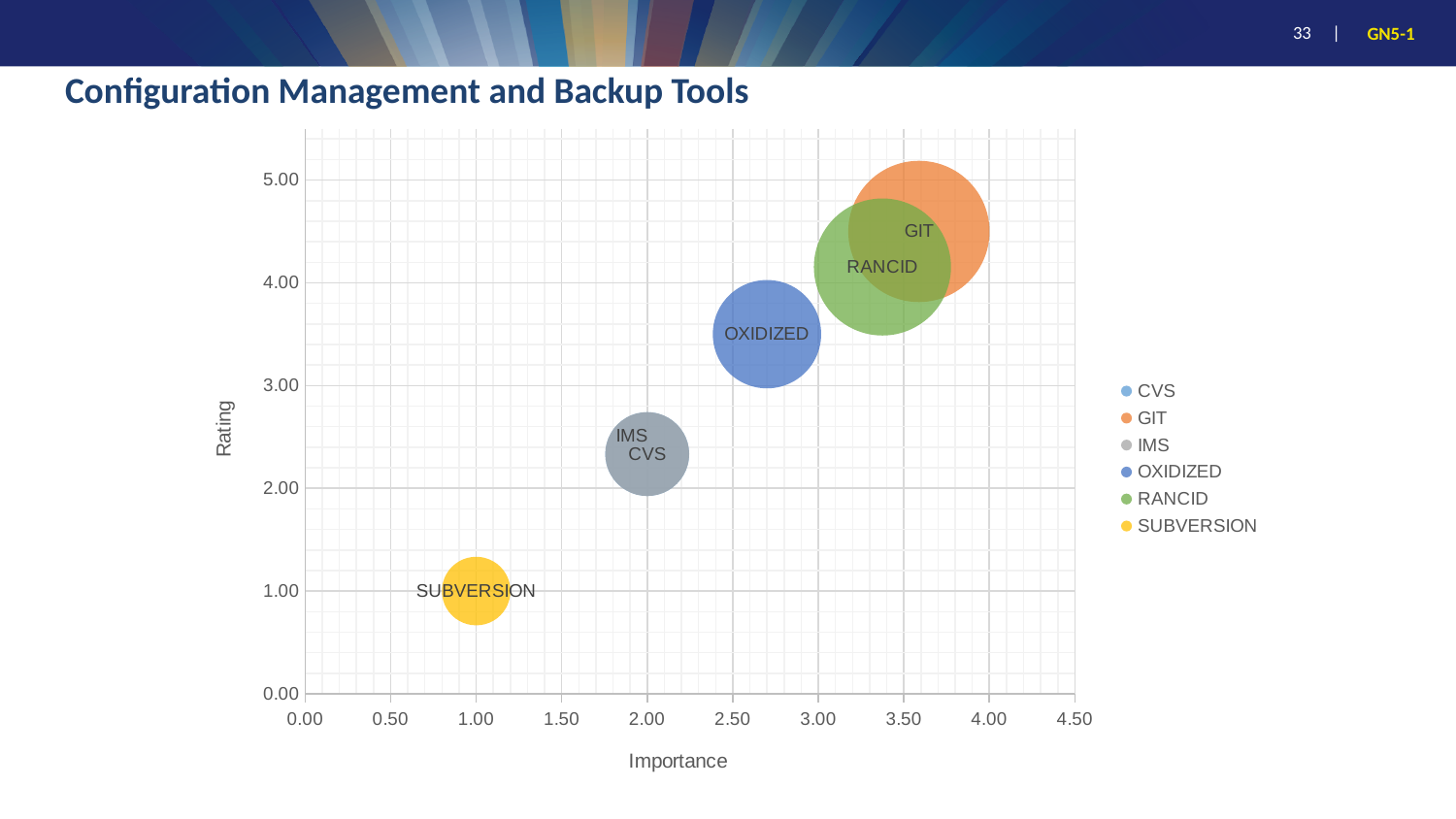
Which tool has the highest rating? GIT How many series does the legend list? 6 What is the label of the horizontal axis? Importance Which has the higher rating, OXIDIZED or SUBVERSION? OXIDIZED Is the rating for SUBVERSION greater or less than 2.00? less What kind of chart is shown on the slide? bubble chart Which has the higher importance, IMS or RANCID? RANCID Which tool has the lowest rating? SUBVERSION Which tool has the lowest importance? SUBVERSION What is the title of the chart? Configuration Management and Backup Tools Is the rating for GIT greater or less than 4.00? greater Is the importance for OXIDIZED greater or less than 2.50? greater